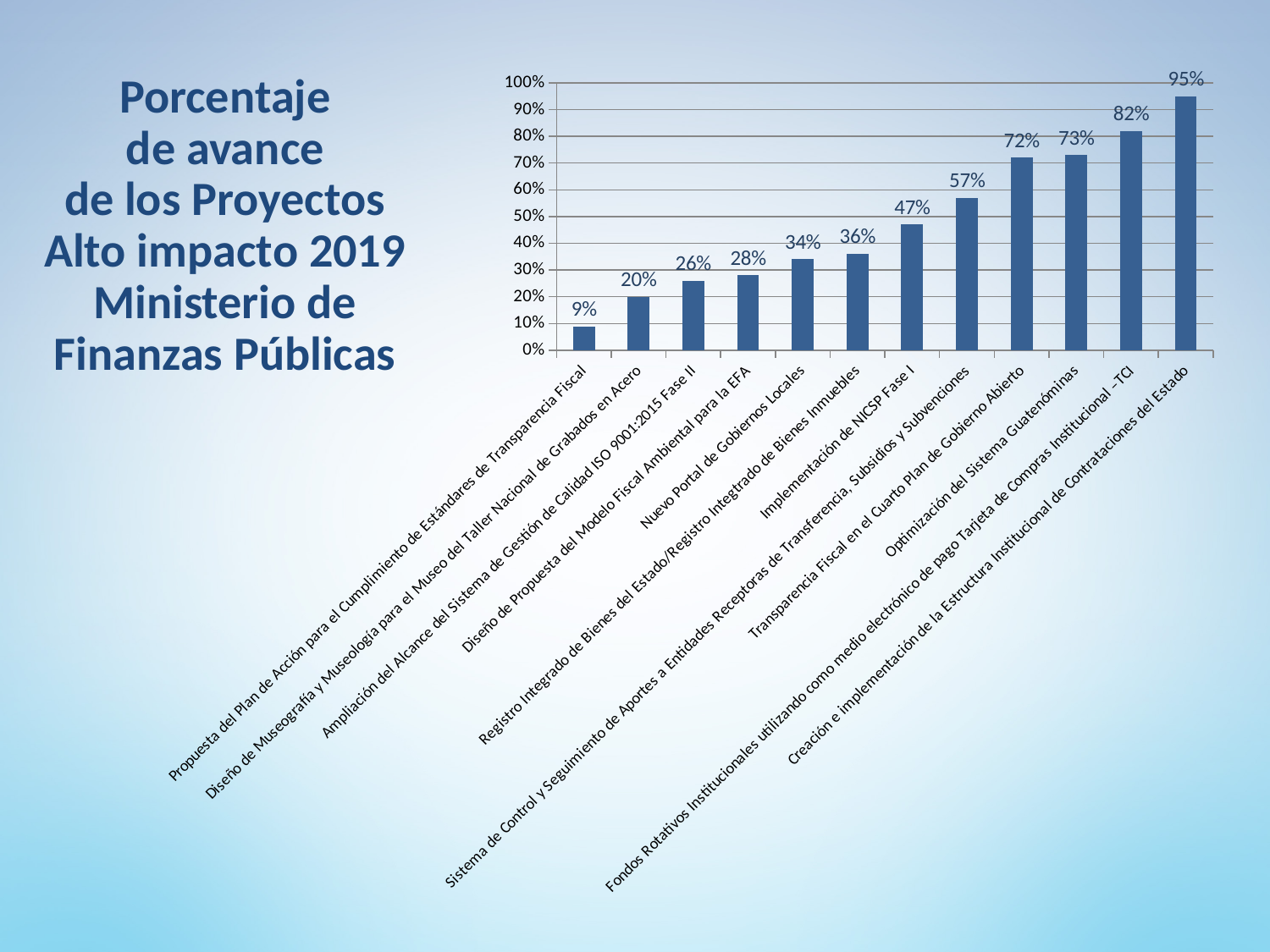
What is the value for 'Optimización del Sistema Guatenóminas'? 73% Do the values rise or fall from left to right along the x axis? Rise What is the percentage of progress shown for 'Nuevo Portal de Gobiernos Locales'? 34% What type of chart is shown on the slide? Bar chart What is the difference between the values for 'Diseño de Propuesta del Modelo Fiscal Ambiental para la EFA' and 'Ampliación del Alcance del Sistema de Gestión de Calidad ISO 9001:2015 Fase II'? 2% Which project has the highest percentage of progress? Creación e implementación de la Estructura Institucional de Contrataciones del Estado What value is shown for 'Implementación de NICSP Fase I'? 47% How many projects are shown in the chart? 12 Which project has the lowest percentage of progress? Propuesta del Plan de Acción para el Cumplimiento de Estándares de Transparencia Fiscal Is the value for 'Fondos Rotativos Institucionales utilizando como medio electrónico de pago Tarjeta de Compras Institucional -TCI' greater or less than 80%? greater Which has a higher value: 'Implementación de NICSP Fase I' or 'Registro Integrado de Bienes del Estado/Registro Integrado de Bienes Inmuebles'? Implementación de NICSP Fase I What is the difference between the value for 'Creación e implementación de la Estructura Institucional de Contrataciones del Estado' and the value for 'Transparencia Fiscal en el Cuarto Plan de Gobierno Abierto'? 23%